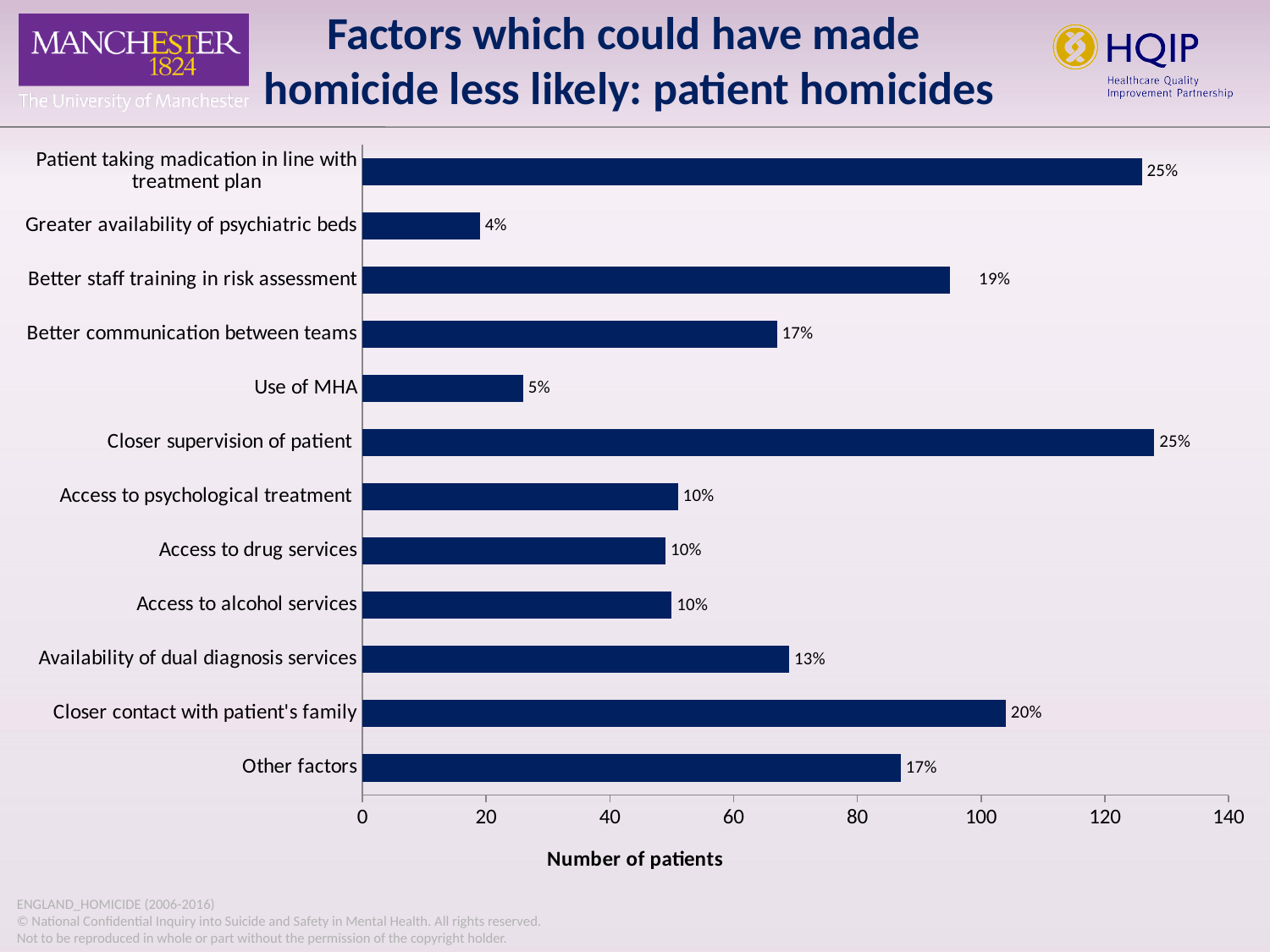
Is the number of patients for Other factors greater or less than 80? greater What is the data label shown for Greater availability of psychiatric beds? 4% What is the difference in percentage points between the labels for Closer supervision of patient and Greater availability of psychiatric beds? 21% What is the data label shown for Closer contact with patient's family? 20% What kind of chart is shown on the slide? Bar chart How many factors are listed in the chart? 12 What is the title of the horizontal axis? Number of patients What is the data label shown for Availability of dual diagnosis services? 13% What is the data label shown for Better staff training in risk assessment? 19% Is the number of patients for Closer supervision of patient greater or less than 120? greater Which has the larger value: Better staff training in risk assessment or Better communication between teams? Better staff training in risk assessment Which factor has the lowest value in the chart? Greater availability of psychiatric beds